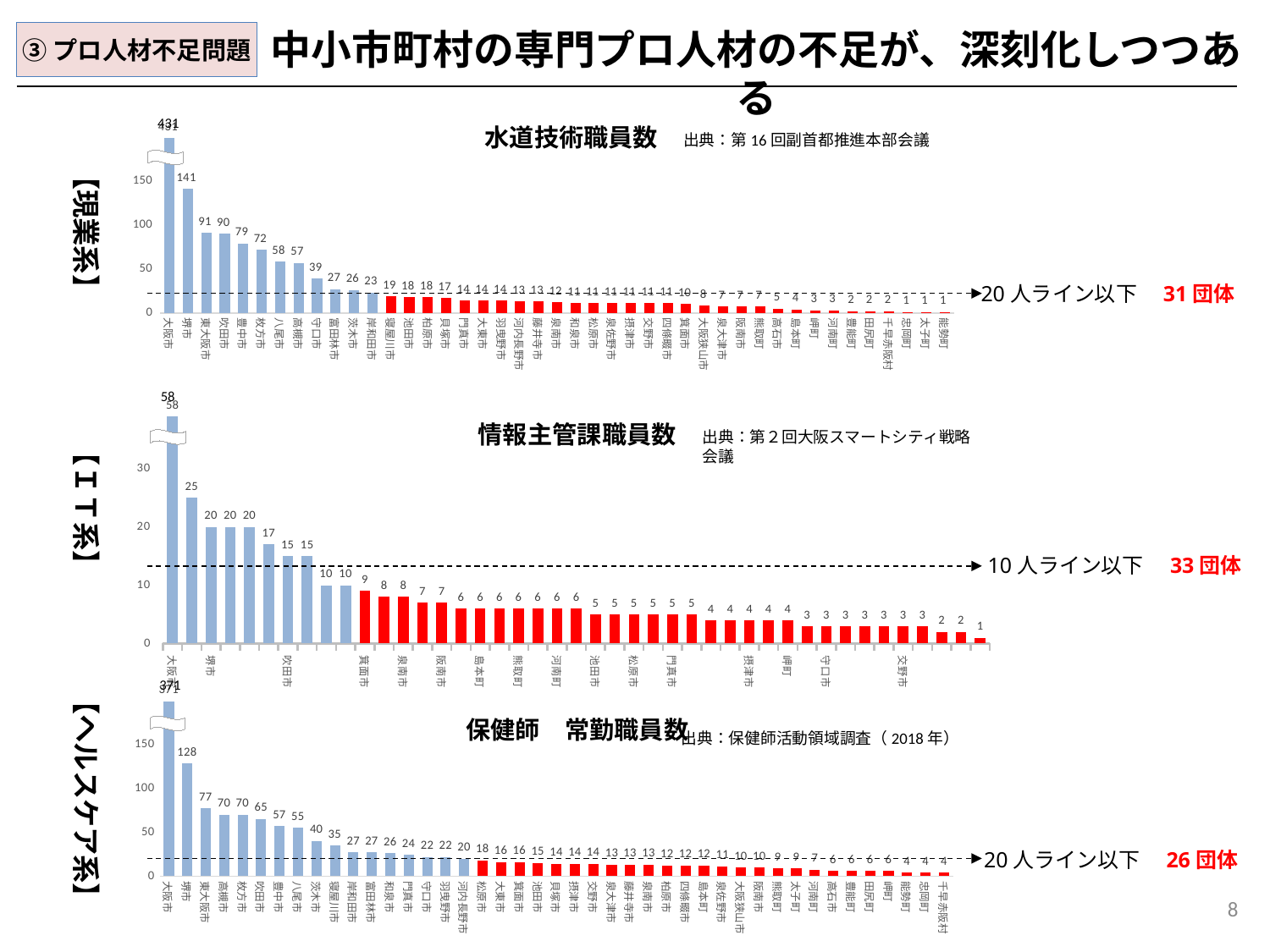
In the 水道技術職員数 chart, which municipality has the highest value? 大阪市 According to the annotation on the 水道技術職員数 chart, how many 団体 are at or below the 20人ライン? 31 団体 In the 情報主管課職員数 chart, what is the value for 箕面市? 9 In the 水道技術職員数 chart, what is the difference between the values for 大阪市 and 堺市? 290 In the 保健師 常勤職員数 chart, what is the value for 堺市? 128 What kind of chart is the 水道技術職員数 chart? bar chart In the 水道技術職員数 chart, what is the value for 堺市? 141 In the 保健師 常勤職員数 chart, what is the value for 大阪市? 371 In the 水道技術職員数 chart, what is the value for 大阪市? 431 In the 保健師 常勤職員数 chart, which is larger, the value for 東大阪市 or the value for 吹田市? 東大阪市 In the 情報主管課職員数 chart, what is the value for 堺市? 20 In the 情報主管課職員数 chart, what is the value for 大阪市? 58